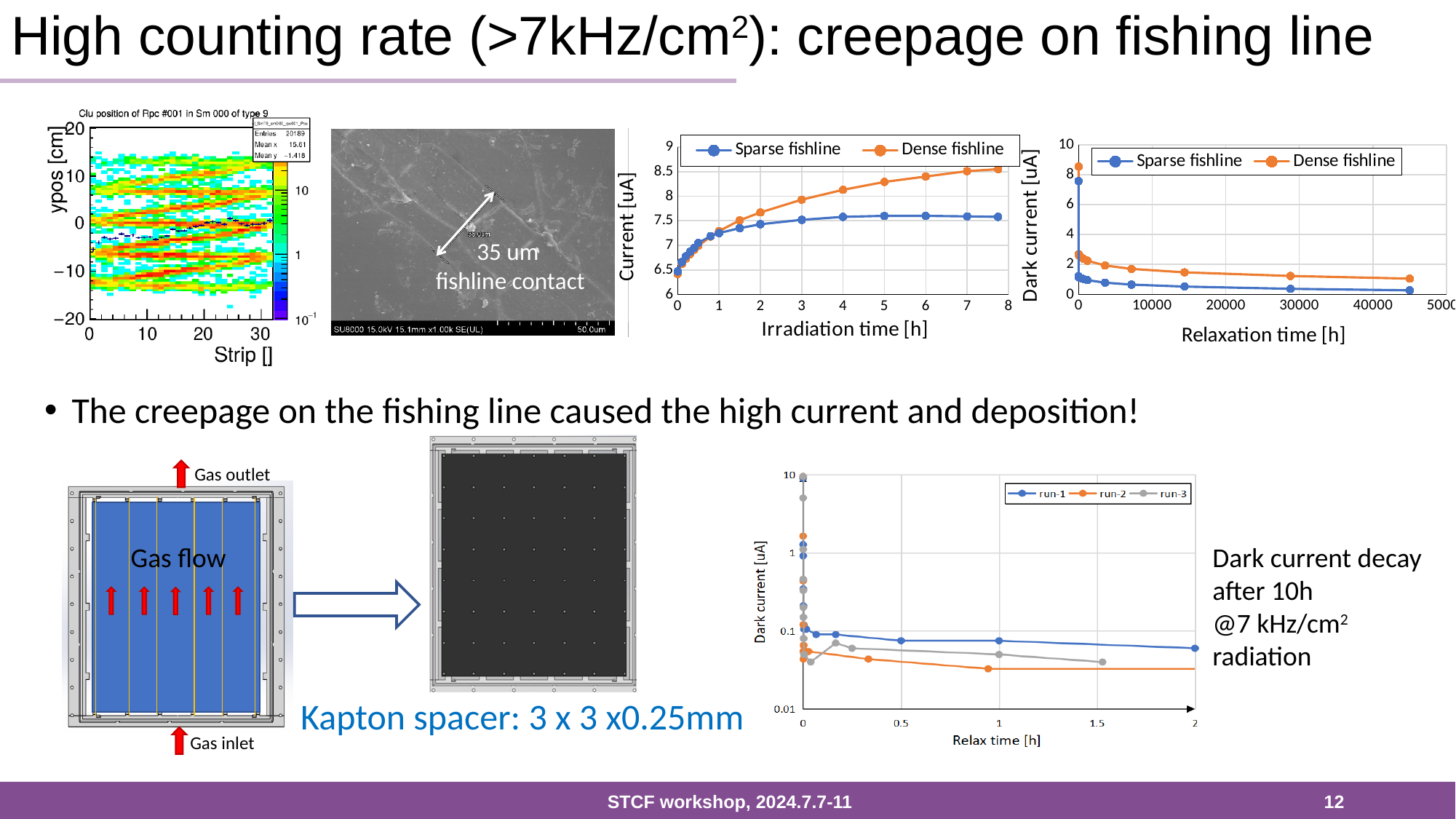
In the chart of Current [uA] versus Irradiation time [h], is the Sparse fishline current at 7 h greater or less than 8? less In the chart of Current [uA] versus Irradiation time [h], is the Dense fishline current at 7 h greater or less than 8? greater In the bottom chart of Dark current [uA] versus Relax time [h], which series has the higher dark current at 1 h, run-1 or run-2? run-1 In the chart of Dark current [uA] versus Relaxation time [h], how many series does the legend list? 2 In the chart of Dark current [uA] versus Relaxation time [h], is the Sparse fishline dark current at 40000 h greater or less than 2? less In the chart of Dark current [uA] versus Relaxation time [h], does the Dense fishline dark current rise or fall as relaxation time increases? fall In the bottom chart of Dark current [uA] versus Relax time [h], how many series does the legend list? 3 In the chart of Current [uA] versus Irradiation time [h], how many series does the legend list? 2 What kind of chart is the Current [uA] versus Irradiation time [h] chart? line chart In the chart of Dark current [uA] versus Relaxation time [h], which series has the higher dark current at 30000 h, Sparse fishline or Dense fishline? Dense fishline In the chart of Current [uA] versus Irradiation time [h], does the Dense fishline current rise or fall as irradiation time increases? rise In the chart of Current [uA] versus Irradiation time [h], which series has the higher current at 7 h, Sparse fishline or Dense fishline? Dense fishline